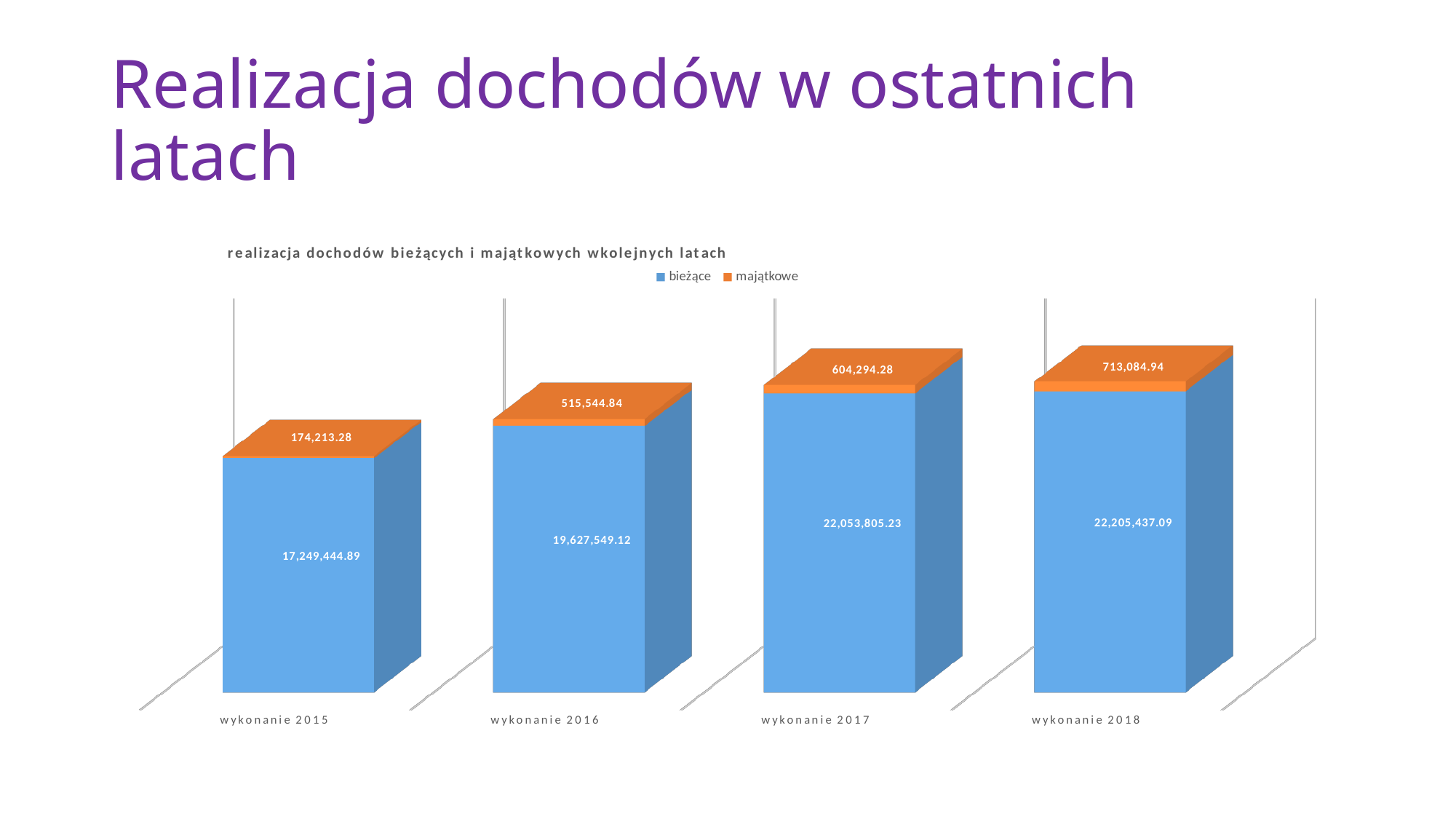
What is the difference between the bieżące values for wykonanie 2018 and wykonanie 2017? 151,631.86 How many series does the legend list? 2 What kind of chart is shown on the slide? stacked bar chart How many years (categories) are shown on the x axis? 4 What is the value of majątkowe for wykonanie 2018? 713,084.94 What is the value of bieżące for wykonanie 2015? 17,249,444.89 What is the value of majątkowe for wykonanie 2016? 515,544.84 Which is larger: the majątkowe value for wykonanie 2017 or for wykonanie 2016? wykonanie 2017 Which year has the highest bieżące value? wykonanie 2018 Do the bieżące values rise or fall from wykonanie 2015 to wykonanie 2018? rise Which year has the lowest majątkowe value? wykonanie 2015 What is the total of the stacked bar for wykonanie 2015? 17,423,658.17